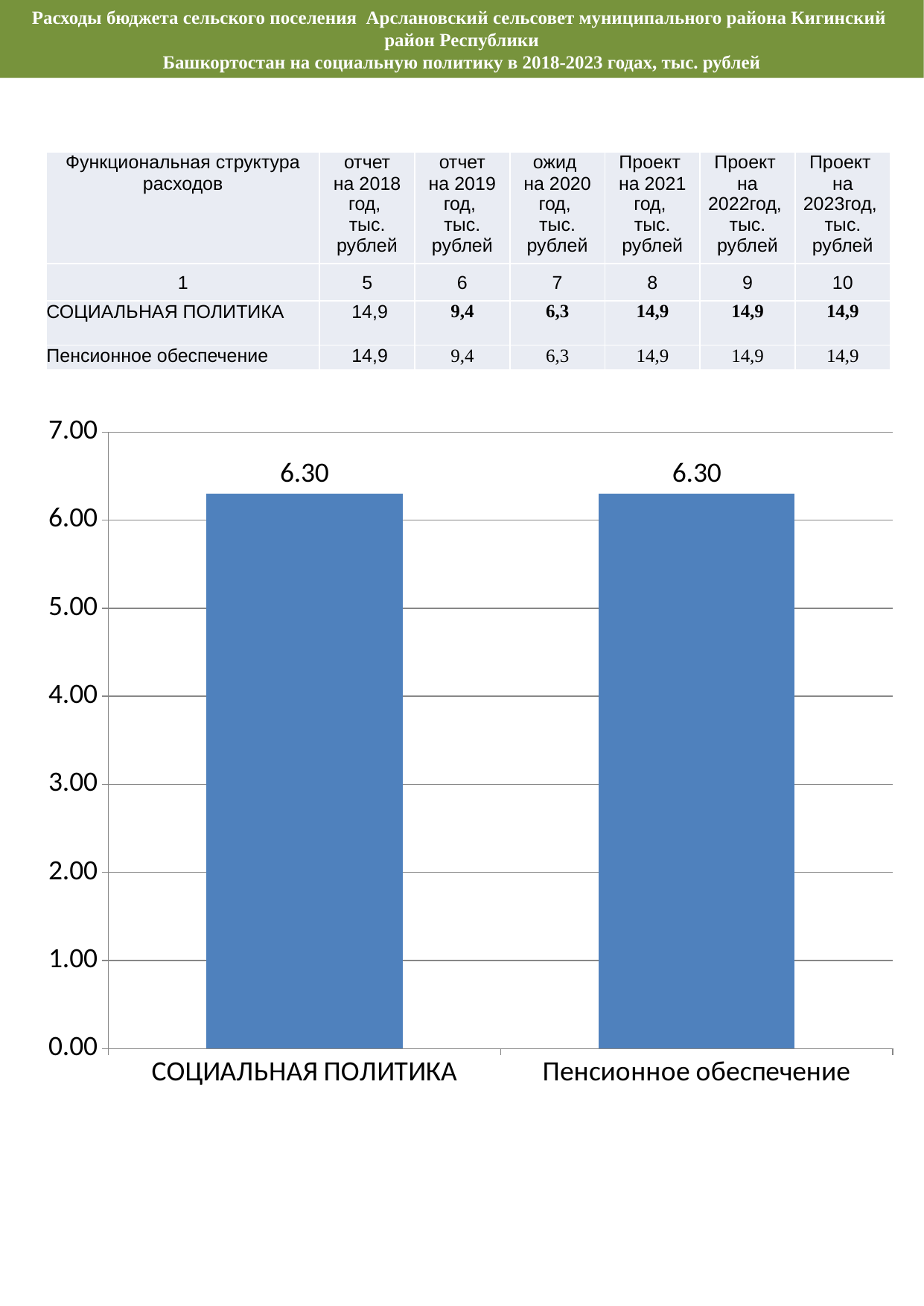
What is the highest value shown on the vertical axis of the chart? 7.00 How many categories are plotted in the chart? 2 What is the difference between the values for СОЦИАЛЬНАЯ ПОЛИТИКА and Пенсионное обеспечение in the chart? 0.00 What is the label of the first category on the x axis of the chart? СОЦИАЛЬНАЯ ПОЛИТИКА Is the value for Пенсионное обеспечение greater or less than 7.00? less What kind of chart is shown on the slide? bar chart Do the values for СОЦИАЛЬНАЯ ПОЛИТИКА and Пенсионное обеспечение in the chart differ? No, both are 6.30 What is the value shown for СОЦИАЛЬНАЯ ПОЛИТИКА in the chart? 6.30 Is the value for СОЦИАЛЬНАЯ ПОЛИТИКА greater or less than 6.00? greater What is the value shown for Пенсионное обеспечение in the chart? 6.30